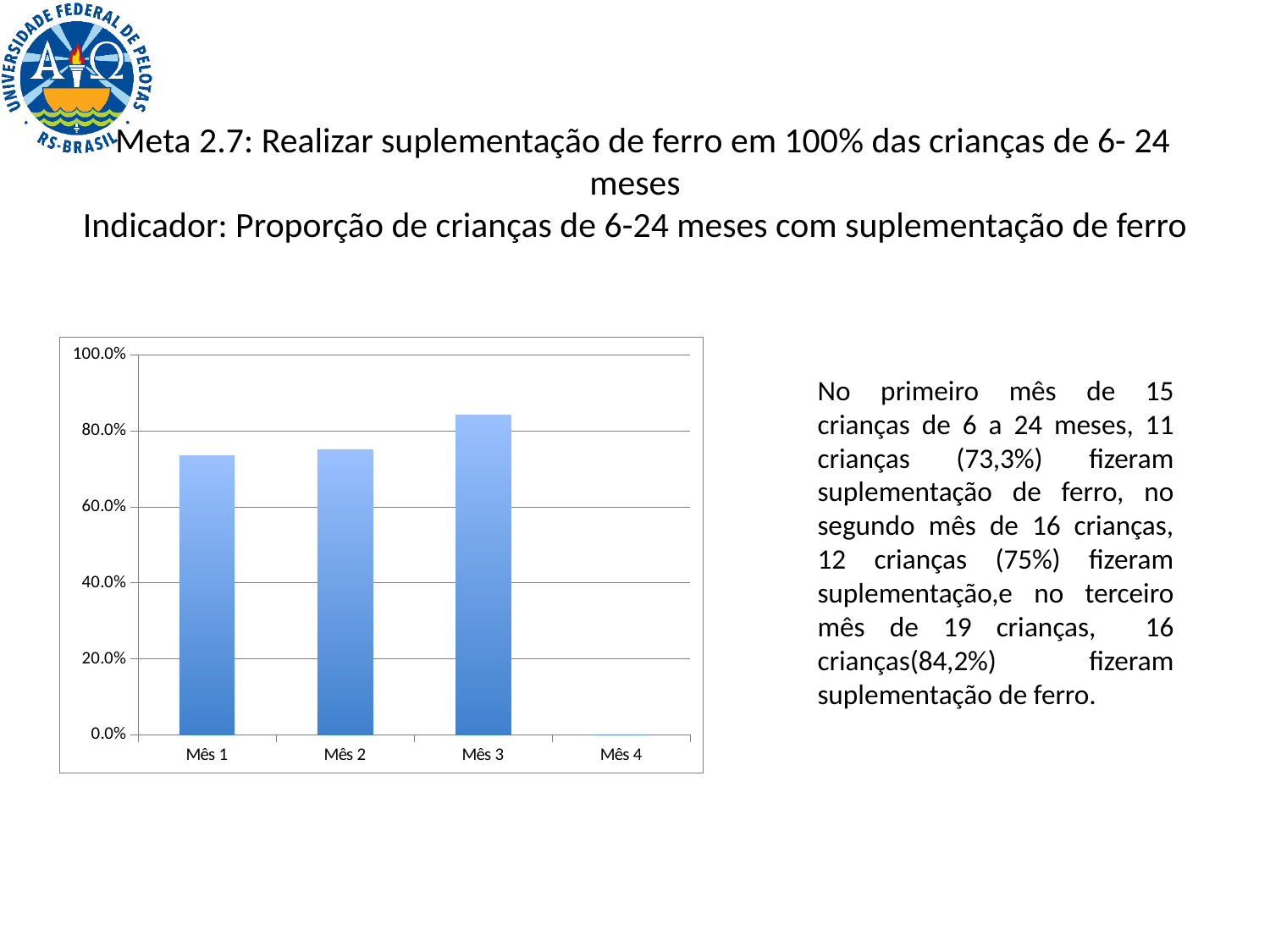
Is the value for Mês 1 greater or less than 60.0%? greater Is the value for Mês 2 greater or less than 80.0%? less Do the values rise or fall from Mês 1 to Mês 3? rise How many categories are shown on the x axis of the chart? 4 What is the label of the category on the far right of the x axis? Mês 4 Which is larger, the value for Mês 2 or the value for Mês 3? Mês 3 What kind of chart is shown on the slide? bar chart Which month has the highest bar in the chart? Mês 3 Is the value for Mês 3 greater or less than 80.0%? greater Which month has the lowest value in the chart? Mês 4